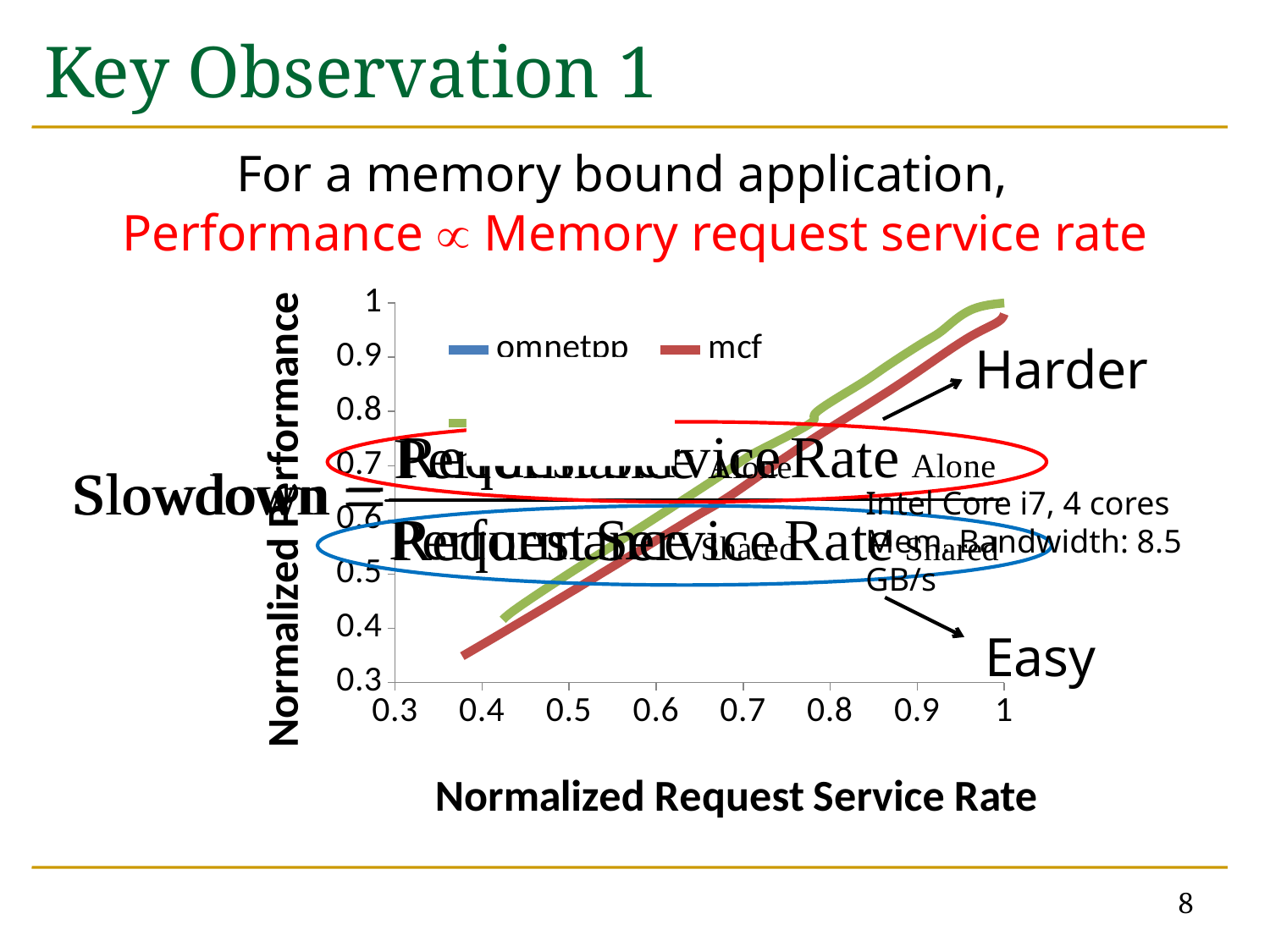
What kind of chart is shown on the slide? line chart What is the title of the x axis of the chart? Normalized Request Service Rate What is the lowest value shown on the x axis of the chart? 0.3 At a normalized request service rate of 0.6, which series has the higher normalized performance, omnetpp or mcf? omnetpp Which two series are listed in the chart legend? omnetpp and mcf Do the plotted values rise or fall as the normalized request service rate increases? rise Is the normalized performance of mcf at a normalized request service rate of 1 greater or less than 0.9? greater Is the normalized performance of mcf at a normalized request service rate of 0.4 greater or less than 0.5? less Is the normalized performance of omnetpp at a normalized request service rate of 0.5 greater or less than 0.7? less